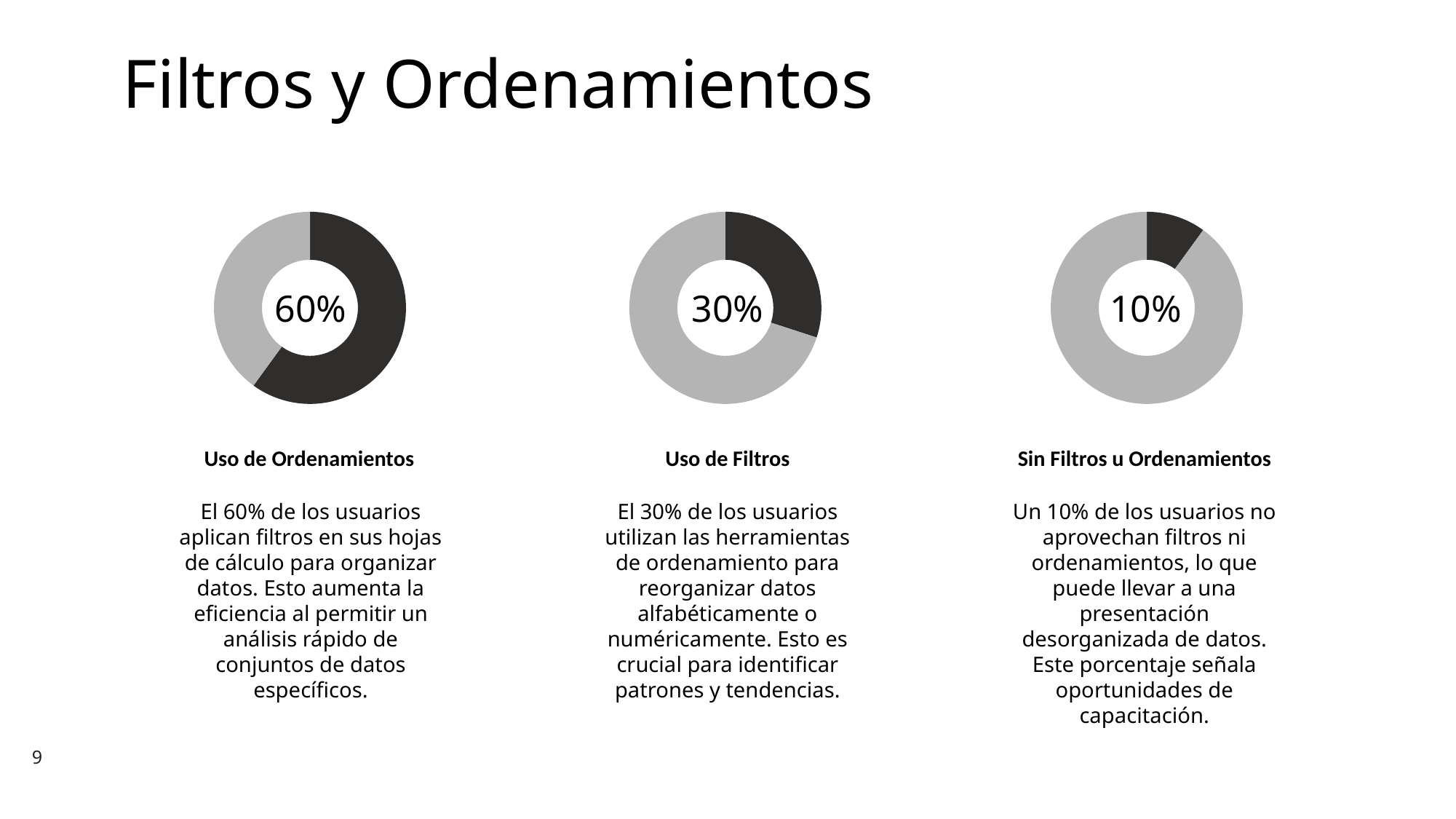
What is the difference between the percentage in the 'Uso de Ordenamientos' chart and the percentage in the 'Uso de Filtros' chart? 30% What kind of chart is used for each of the three figures on the slide? Donut chart What is the difference between the percentage in the 'Uso de Filtros' chart and the percentage in the 'Sin Filtros u Ordenamientos' chart? 20% What value is shown in the centre of the 'Uso de Filtros' donut chart? 30% Which is larger: the percentage in the 'Uso de Filtros' chart or the percentage in the 'Sin Filtros u Ordenamientos' chart? Uso de Filtros How many donut charts are on the slide? 3 Which of the three donut charts shows the highest percentage? Uso de Ordenamientos What value is shown in the centre of the 'Sin Filtros u Ordenamientos' donut chart? 10% Which of the three donut charts shows the lowest percentage? Sin Filtros u Ordenamientos What is the total of the three percentages shown in the donut charts? 100% What value is shown in the centre of the 'Uso de Ordenamientos' donut chart? 60% What is the title of the slide containing the three donut charts? Filtros y Ordenamientos